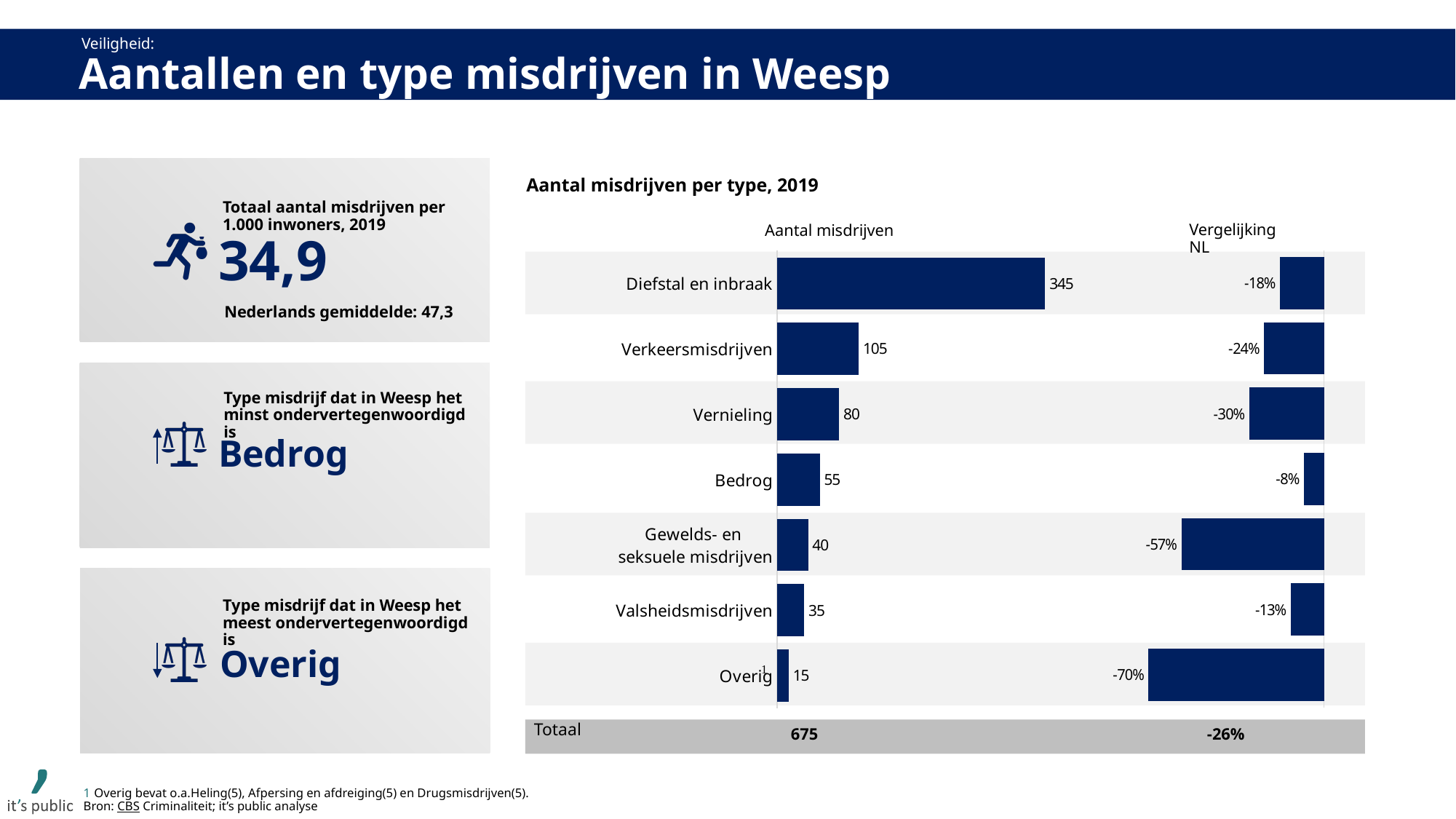
In the chart 'Aantal misdrijven per type, 2019', which crime type has the highest 'Aantal misdrijven'? Diefstal en inbraak In the chart 'Aantal misdrijven per type, 2019', which crime type has the lowest 'Aantal misdrijven'? Overig In the chart 'Aantal misdrijven per type, 2019', which has a higher 'Aantal misdrijven': Vernieling or Bedrog? Vernieling In the chart 'Aantal misdrijven per type, 2019', how many crime types are shown (excluding the Totaal row)? 7 In the chart 'Aantal misdrijven per type, 2019', what is the difference in 'Aantal misdrijven' between Diefstal en inbraak and Verkeersmisdrijven? 240 What kind of chart is 'Aantal misdrijven per type, 2019'? Bar chart In the chart 'Aantal misdrijven per type, 2019', what is the total 'Aantal misdrijven' shown in the Totaal row? 675 In the chart 'Aantal misdrijven per type, 2019', what is the 'Vergelijking NL' value for Vernieling? -30% In the chart 'Aantal misdrijven per type, 2019', what is the 'Aantal misdrijven' value for Diefstal en inbraak? 345 In the chart 'Aantal misdrijven per type, 2019', which crime type has the most negative 'Vergelijking NL' value? Overig In the chart 'Aantal misdrijven per type, 2019', what is the 'Aantal misdrijven' value for Gewelds- en seksuele misdrijven? 40 In the chart 'Aantal misdrijven per type, 2019', what is the 'Vergelijking NL' value in the Totaal row? -26%